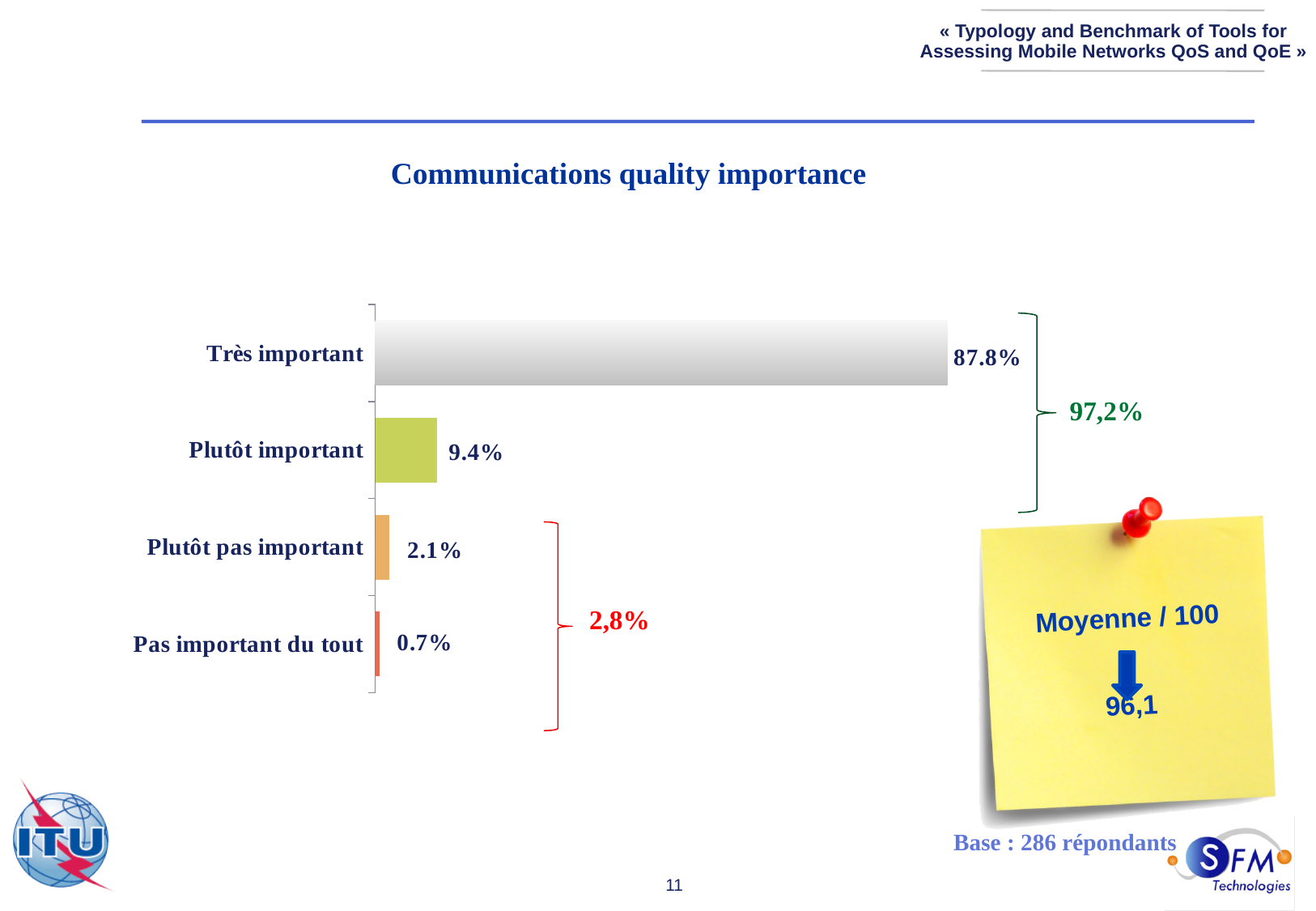
Which category has the lowest value? Pas important du tout What is the value for "Très important"? 87.8% What is the value for "Plutôt pas important"? 2.1% What kind of chart is shown on the slide? Bar chart What is the value for "Pas important du tout"? 0.7% What is the difference between the values for "Très important" and "Plutôt important"? 78.4% How many categories are shown in the chart? 4 What is the title of the chart? Communications quality importance What is the value for "Plutôt important"? 9.4% What combined percentage is shown by the green bracket grouping "Très important" and "Plutôt important"? 97,2% Which category has the highest value? Très important Which is larger, the value for "Plutôt pas important" or "Pas important du tout"? Plutôt pas important